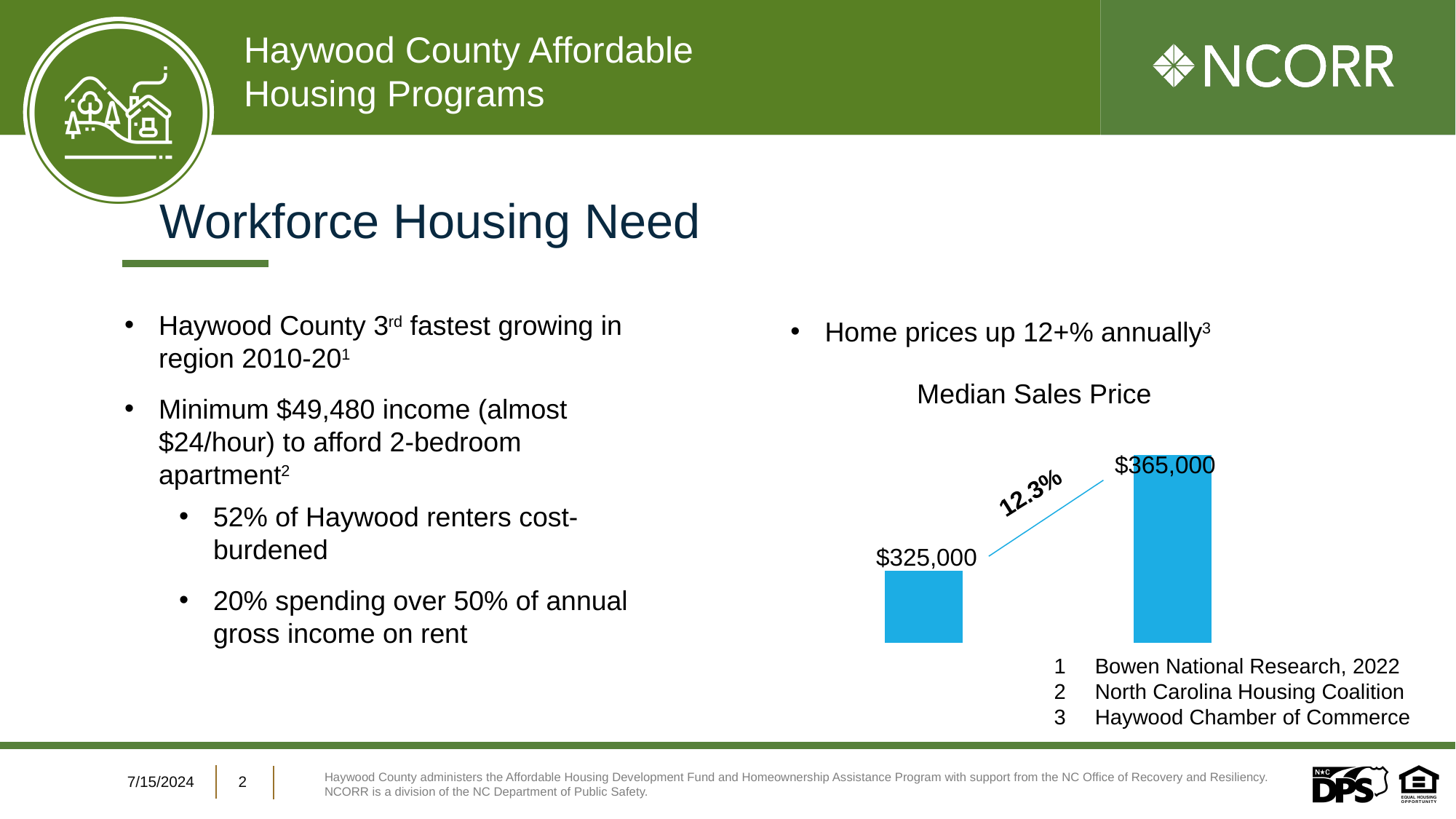
How many bars are plotted in the Median Sales Price chart? 2 In the Median Sales Price chart, which bar is higher, the left or the right? right In the Median Sales Price chart, what is the value of the left bar? $325,000 In the Median Sales Price chart, what is the highest value shown? $365,000 In the Median Sales Price chart, what is the difference between the right bar and the left bar? $40,000 In the Median Sales Price chart, what is the lowest value shown? $325,000 What is the title of the chart on the slide? Median Sales Price What percentage change is annotated between the two bars in the Median Sales Price chart? 12.3% In the Median Sales Price chart, what is the value of the right bar? $365,000 What kind of chart is the Median Sales Price chart? bar chart Do the values in the Median Sales Price chart rise or fall from left to right? rise